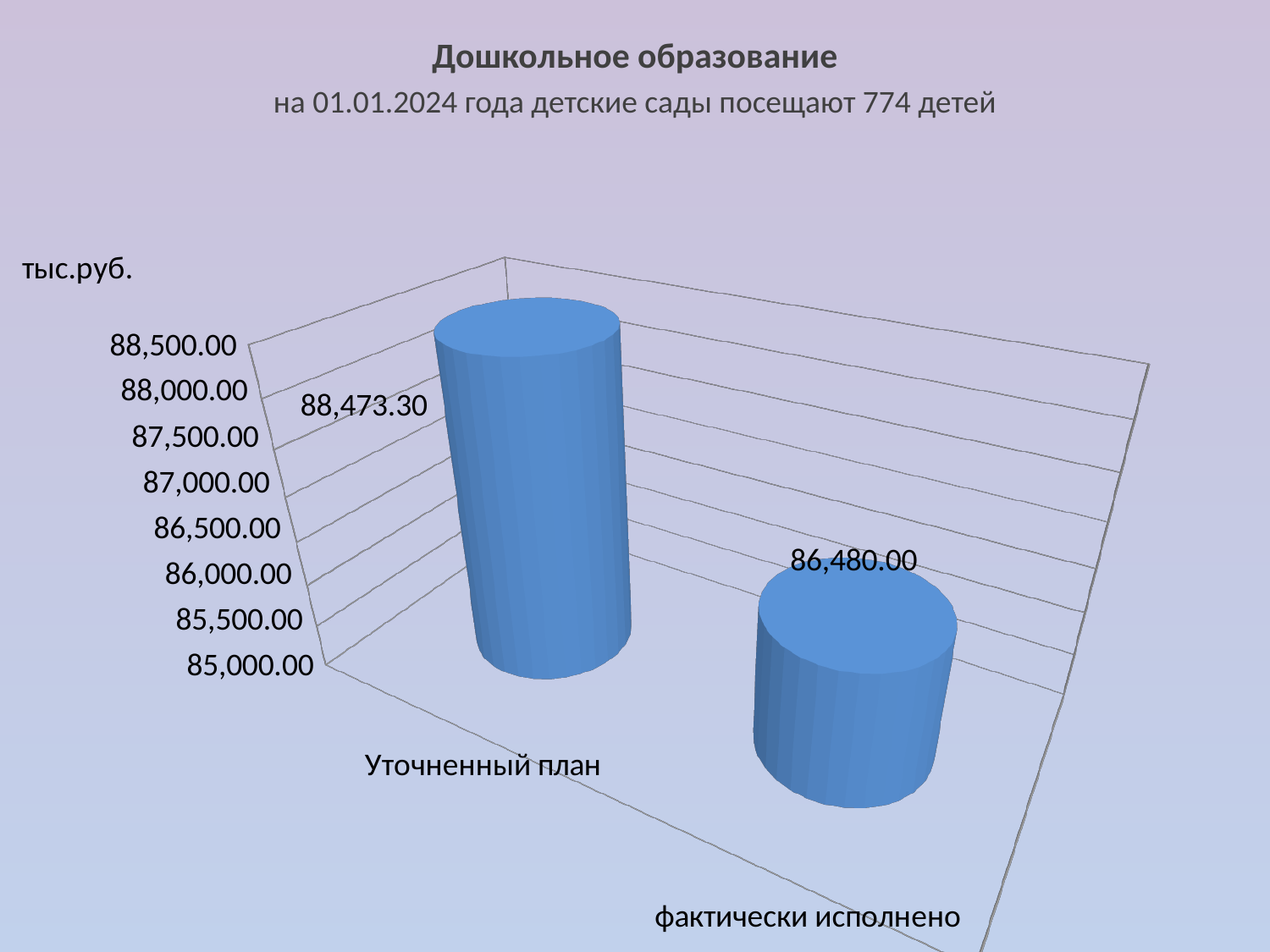
Is the value for "Уточненный план" greater or less than 88,000.00? greater What unit is shown on the value axis of the chart? тыс.руб. Which category has the highest value? Уточненный план What is the value for "фактически исполнено"? 86,480.00 Which category has the lowest value? фактически исполнено What kind of chart is shown on the slide? bar chart What is the difference between the value for "Уточненный план" and the value for "фактически исполнено"? 1,993.30 How many categories are plotted on the chart? 2 What is the value for "Уточненный план"? 88,473.30 What is the title of the chart? Дошкольное образование Which is larger: the value for "Уточненный план" or the value for "фактически исполнено"? Уточненный план Is the value for "фактически исполнено" greater or less than 87,000.00? less